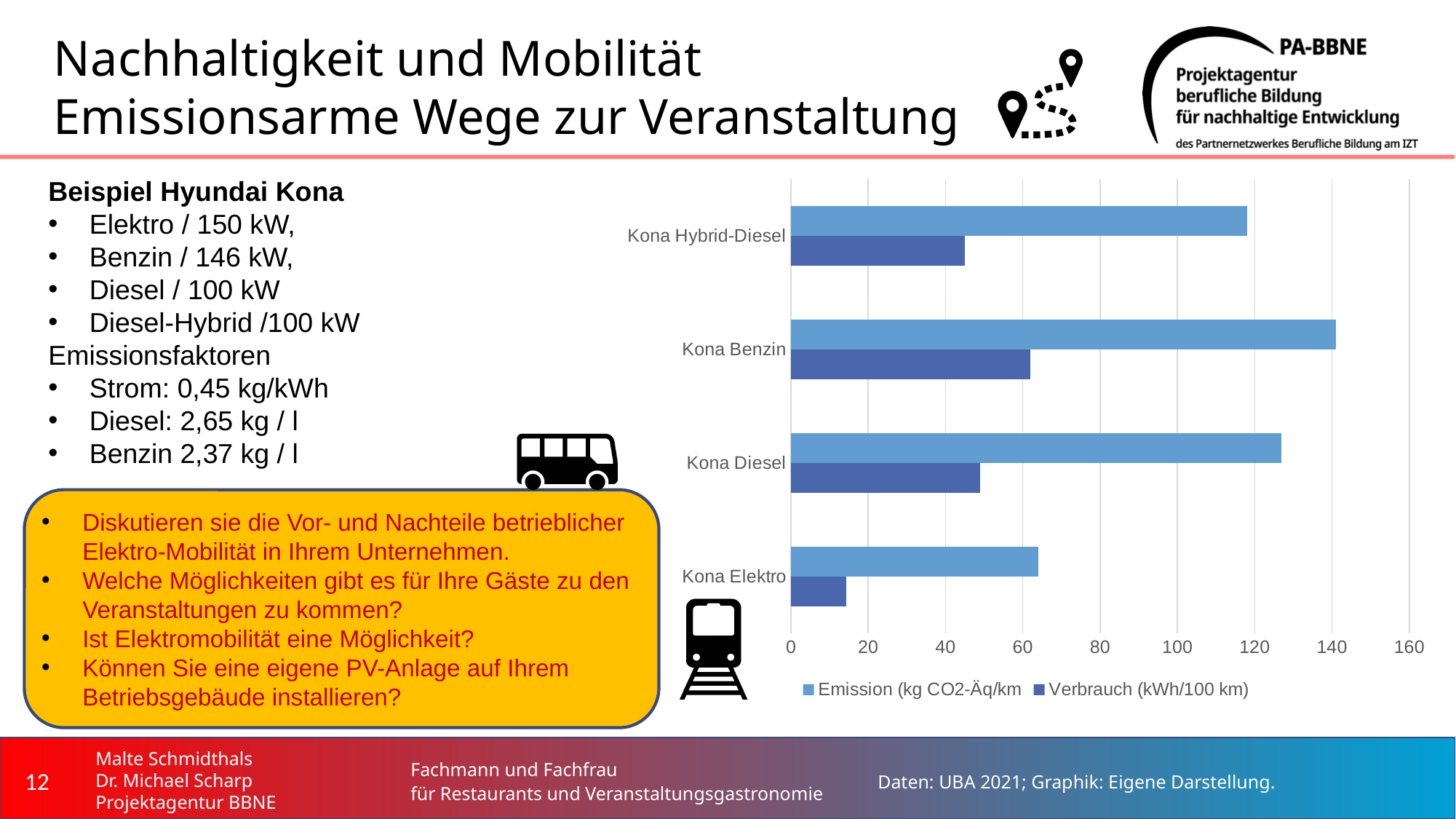
Which vehicle has the lowest Emission (kg CO2-Äq/km) value? Kona Elektro Which is larger: the Emission value for Kona Diesel or for Kona Hybrid-Diesel? Kona Diesel How many series does the chart legend list? 2 Which vehicle has the highest Emission (kg CO2-Äq/km) value? Kona Benzin Is the Verbrauch value for Kona Elektro greater or less than 20? less Which vehicle has the lowest Verbrauch (kWh/100 km) value? Kona Elektro What are the two series named in the chart legend? Emission (kg CO2-Äq/km) and Verbrauch (kWh/100 km) Which vehicle has the highest Verbrauch (kWh/100 km) value? Kona Benzin How many vehicle categories are shown on the chart? 4 Is the Emission value for Kona Elektro greater or less than 80? less What kind of chart is shown on the slide? bar chart